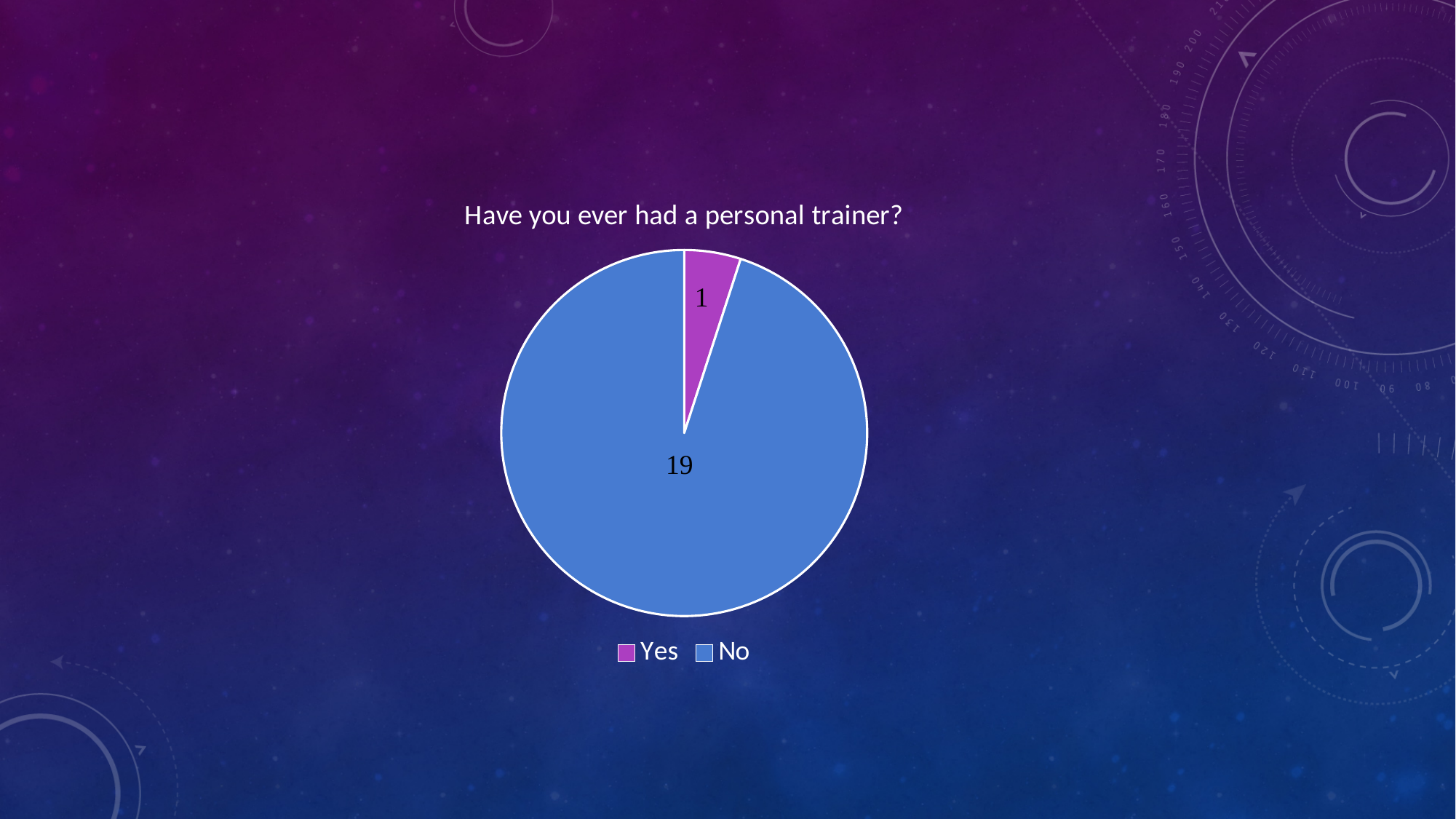
How many entries does the legend list? 2 How many people answered "Yes"? 1 How many people answered "No"? 19 What kind of chart is shown on the slide? pie chart How many categories does the pie chart have? 2 What is the title of the chart? Have you ever had a personal trainer? Which is larger, the "Yes" slice or the "No" slice? No What is the difference between the number of "No" and "Yes" responses? 18 Which response has the largest slice of the pie? No What share of the responses is "Yes"? 5% What is the total number of responses shown in the pie chart? 20 Which response has the smallest slice of the pie? Yes